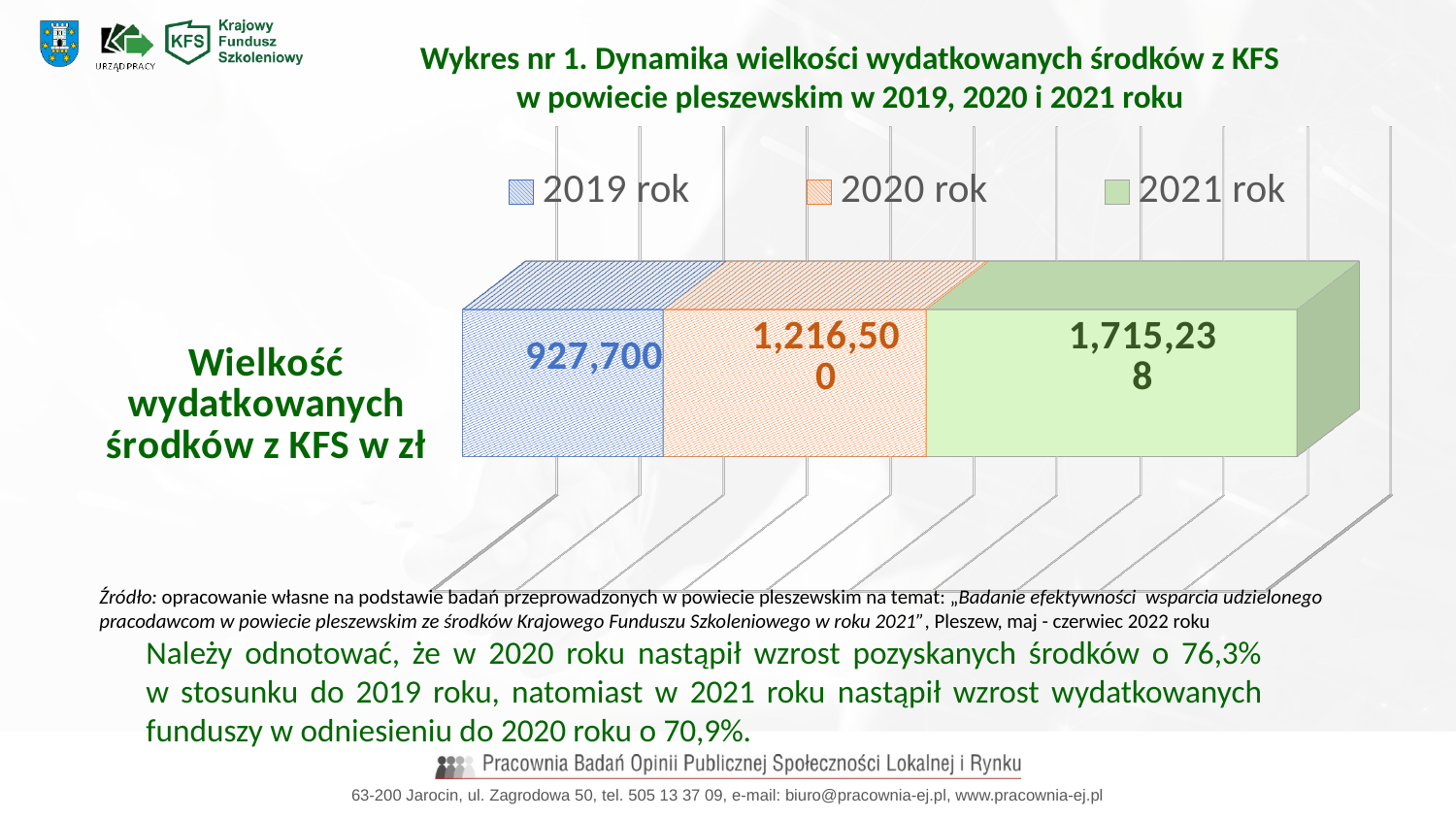
What is the total of the stacked bar across all three years? 3,859,438 Which is larger, the value for 2020 rok or the value for 2021 rok? 2021 rok What is the difference between the values for 2021 rok and 2020 rok? 498,738 What is the value for 2021 rok in the chart? 1,715,238 What kind of chart is shown on the slide? Stacked bar chart How many series does the legend list? 3 What is the title of the chart? Wykres nr 1. Dynamika wielkości wydatkowanych środków z KFS w powiecie pleszewskim w 2019, 2020 i 2021 roku Which year has the lowest value of expended KFS funds? 2019 rok What is the value for 2020 rok in the chart? 1,216,500 Which year has the highest value of expended KFS funds? 2021 rok What is the value for 2019 rok in the chart? 927,700 What is the difference between the values for 2020 rok and 2019 rok? 288,800